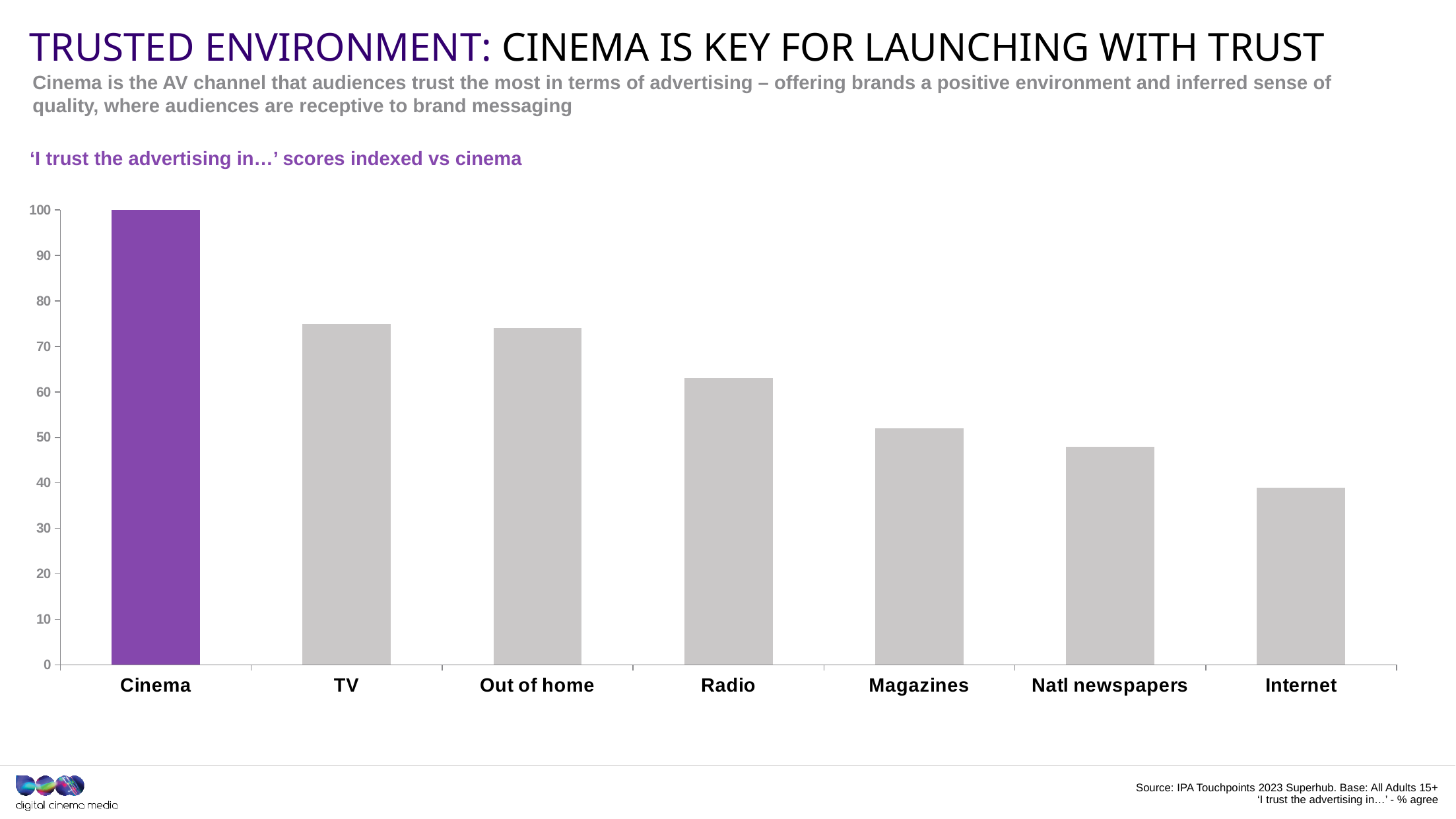
Do the values rise or fall moving from left to right along the x axis? Fall Which is larger, the value for Radio or the value for Magazines? Radio What kind of chart is shown on the slide? Bar chart How many categories are shown on the x axis? 7 Which category has the highest value? Cinema Is the value for Natl newspapers greater or less than 50? less Is the value for Radio greater or less than 60? greater Is the value for Magazines greater or less than 60? less What is the value for Cinema? 100 Which category has the lowest value? Internet